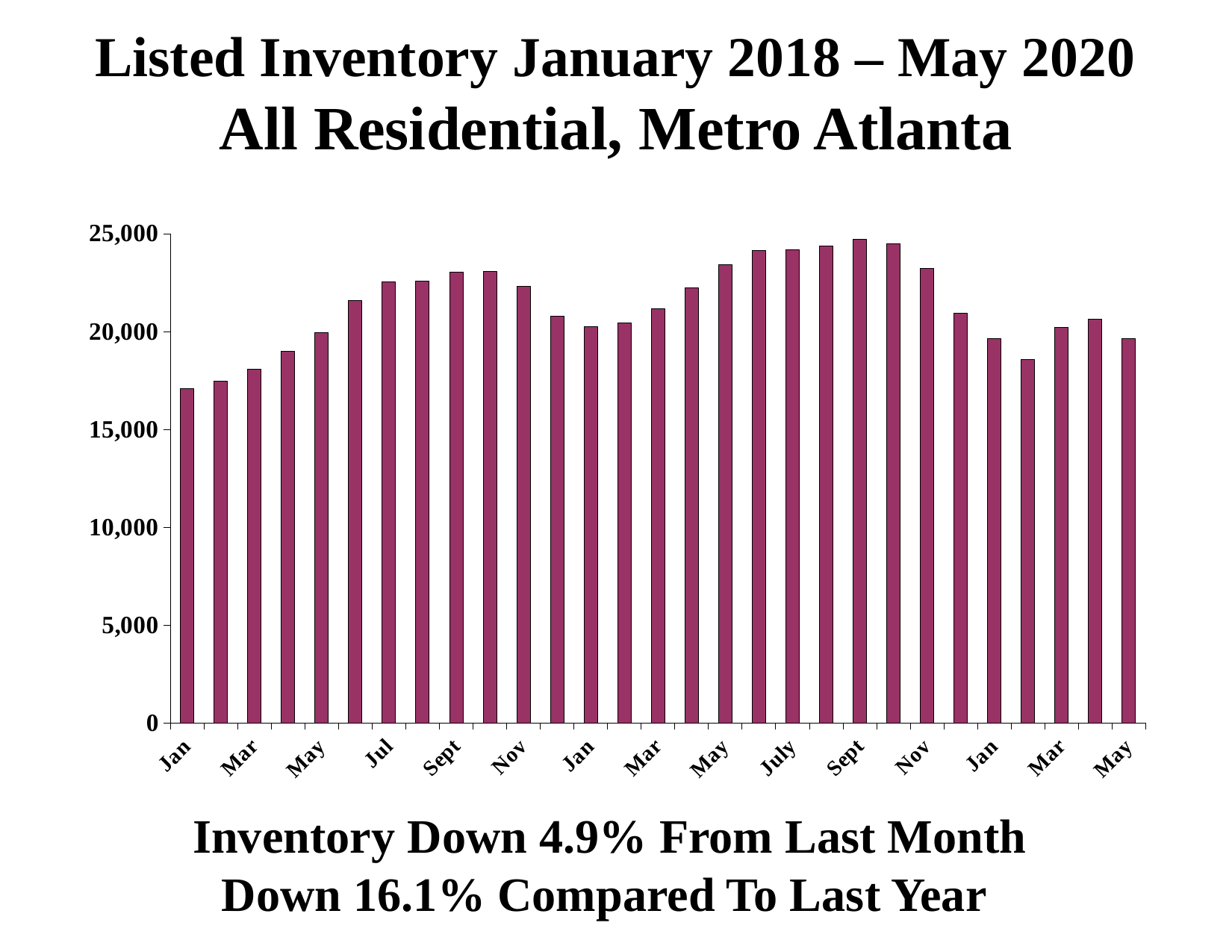
Is the value for the first Jul bar (July 2018) greater or less than 25,000? less What is the title of the chart? Listed Inventory January 2018 – May 2020 All Residential, Metro Atlanta Is the value for the Sept 2019 bar (the second Sept label) greater or less than 20,000? greater What kind of chart is shown on the slide? bar chart How many bars are plotted in the chart? 29 Which is larger: the second Sept bar (September 2019) or the first Sept bar (September 2018)? September 2019 Is the value for the last May bar (May 2020) greater or less than 15,000? greater What is the highest value shown on the vertical axis? 25,000 Which is larger: the first Jan bar (January 2018) or the last May bar (May 2020)? May 2020 Do the values rise or fall from the first Jan bar to the first Sept bar? rise